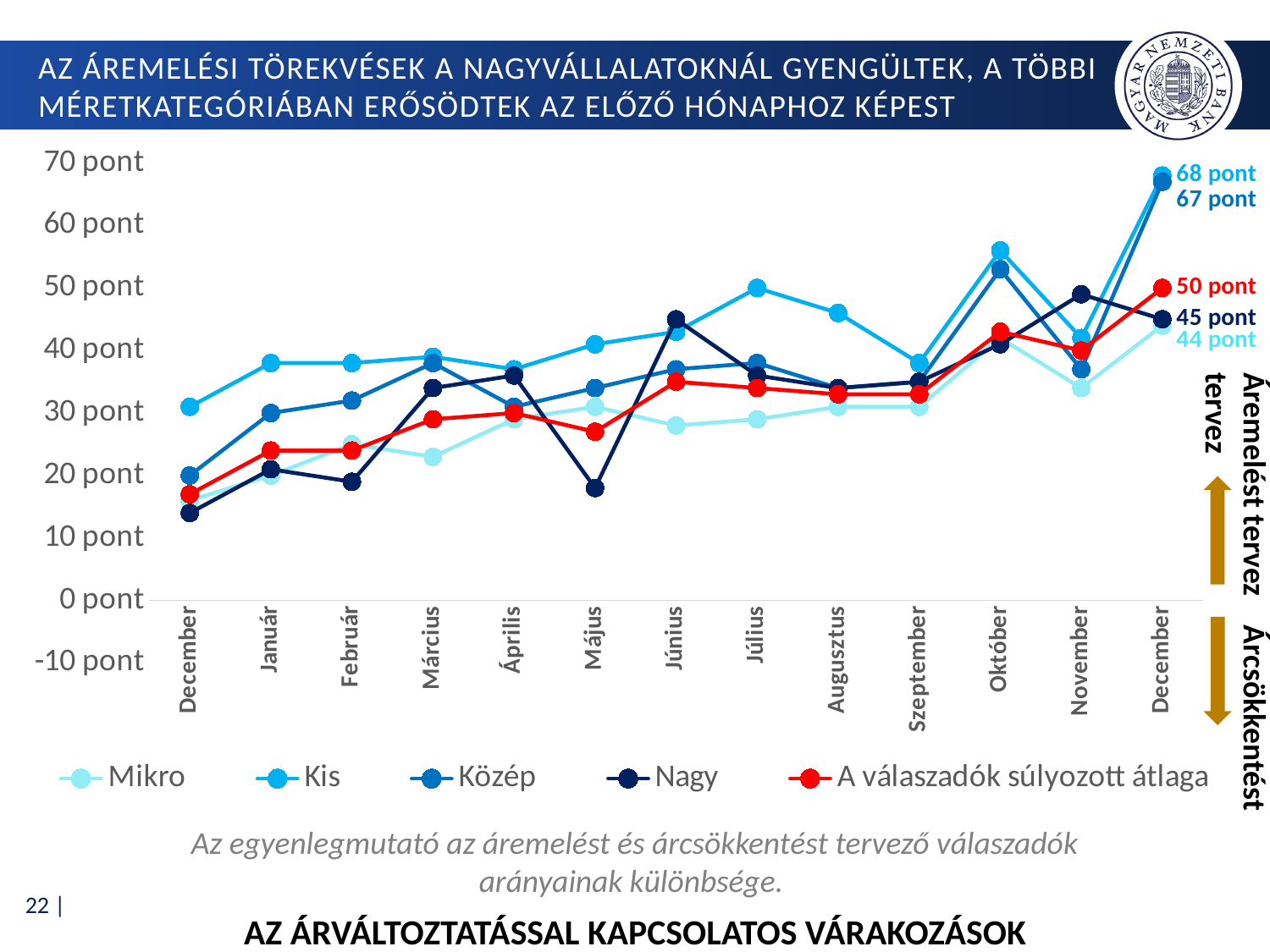
Which series has the lowest value in the final December? Mikro What kind of chart is shown on the slide? line chart What is the difference between Kis and Mikro in the final December? 24 pont What is the value for Nagy in the final December? 45 pont What is the value for Kis in the final December? 68 pont What is the value for A válaszadók súlyozott átlaga in the final December? 50 pont How many series does the legend list? 5 In the final December, which is larger: Kis or Közép? Kis Is the value for Kis in Október greater or less than 50 pont? greater What is the value for Közép in the final December? 67 pont Which series has the highest value in the final December? Kis How many months are shown on the x axis? 13